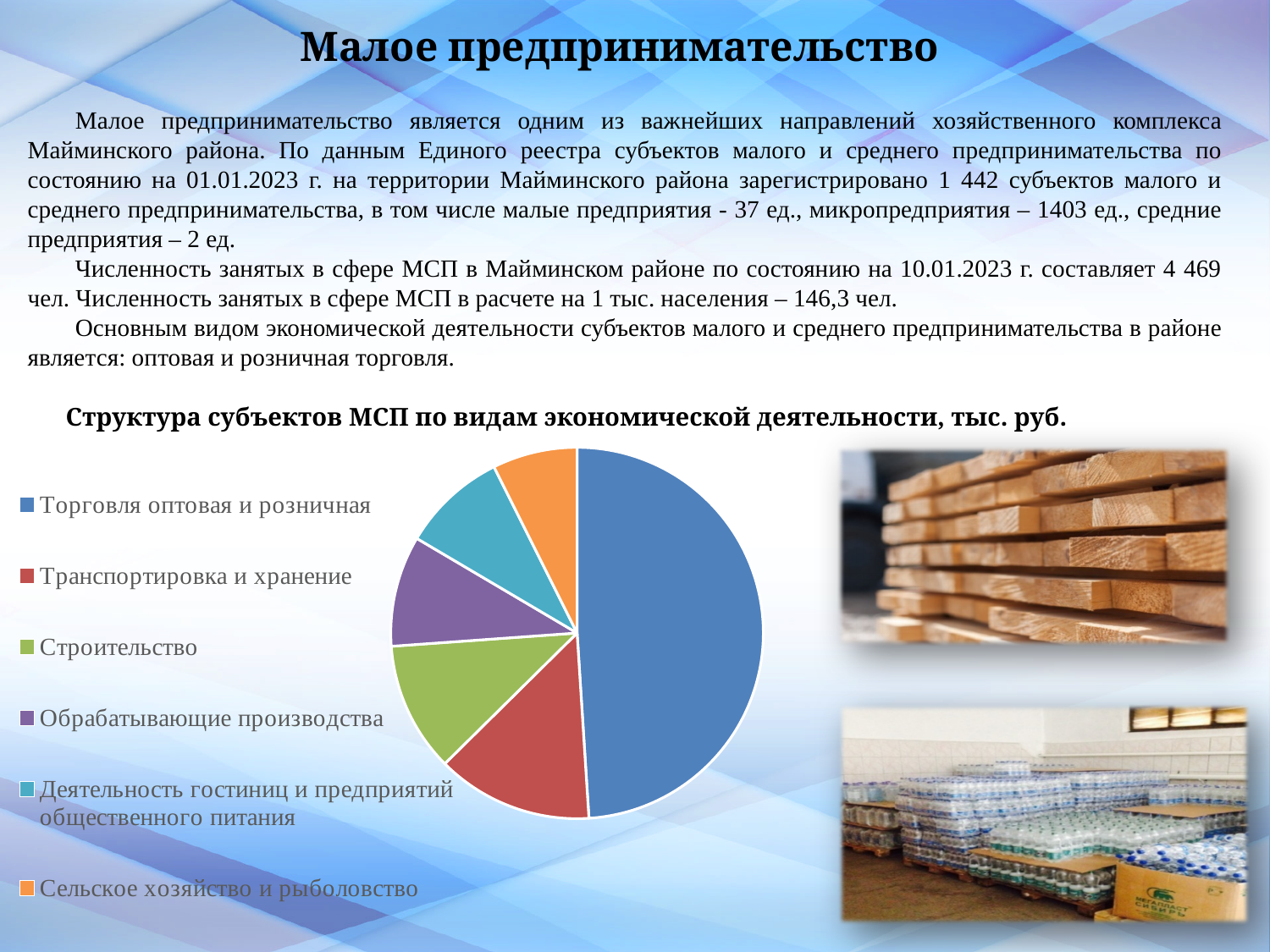
Which slice is larger: Торговля оптовая и розничная or Транспортировка и хранение? Торговля оптовая и розничная What kind of chart is shown on the slide? pie chart What colour is the slice for Торговля оптовая и розничная? blue Which slice is larger: Строительство or Сельское хозяйство и рыболовство? Строительство How many categories does the pie chart show? 6 Which category has the largest slice in the pie chart? Торговля оптовая и розничная Which slice is larger: Транспортировка и хранение or Сельское хозяйство и рыболовство? Транспортировка и хранение What is the title of the pie chart? Структура субъектов МСП по видам экономической деятельности, тыс. руб.